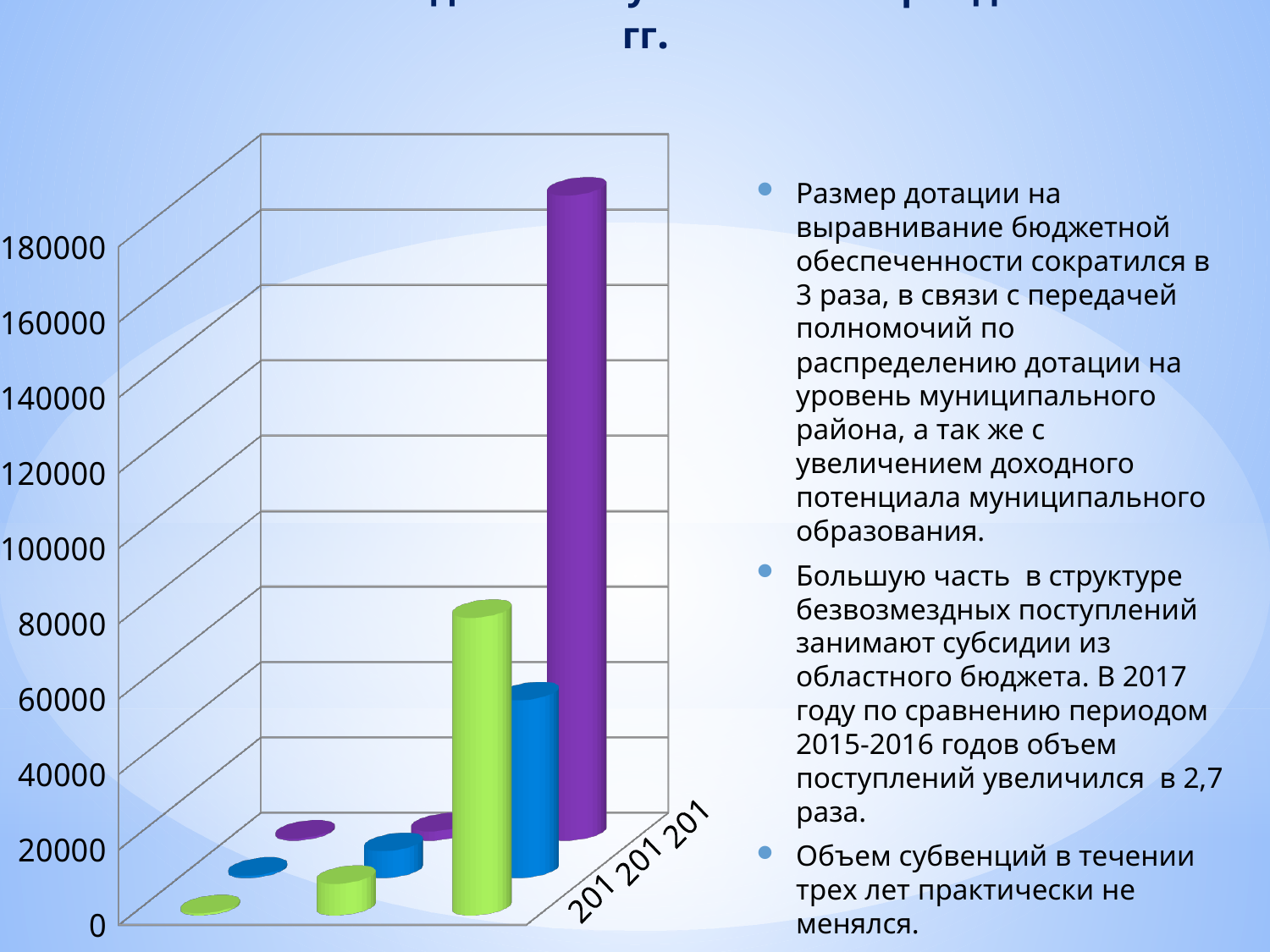
In the rightmost group, is the purple bar or the green bar taller? purple Is the value of the blue bar in the rightmost group greater or less than 80000? less Is the value of the green bar in the rightmost group greater or less than 60000? greater How many groups of bars are plotted along the x axis? 3 In the rightmost group, which coloured bar is the shortest? blue In the rightmost group, which coloured bar is the tallest? purple Do the purple bars rise or fall from the leftmost group to the rightmost group? rise Are all the bars in the leftmost group greater or less than 20000? less How many bars are there in each group? 3 What is the highest value labelled on the vertical axis? 180000 What kind of chart is shown on the slide? bar chart